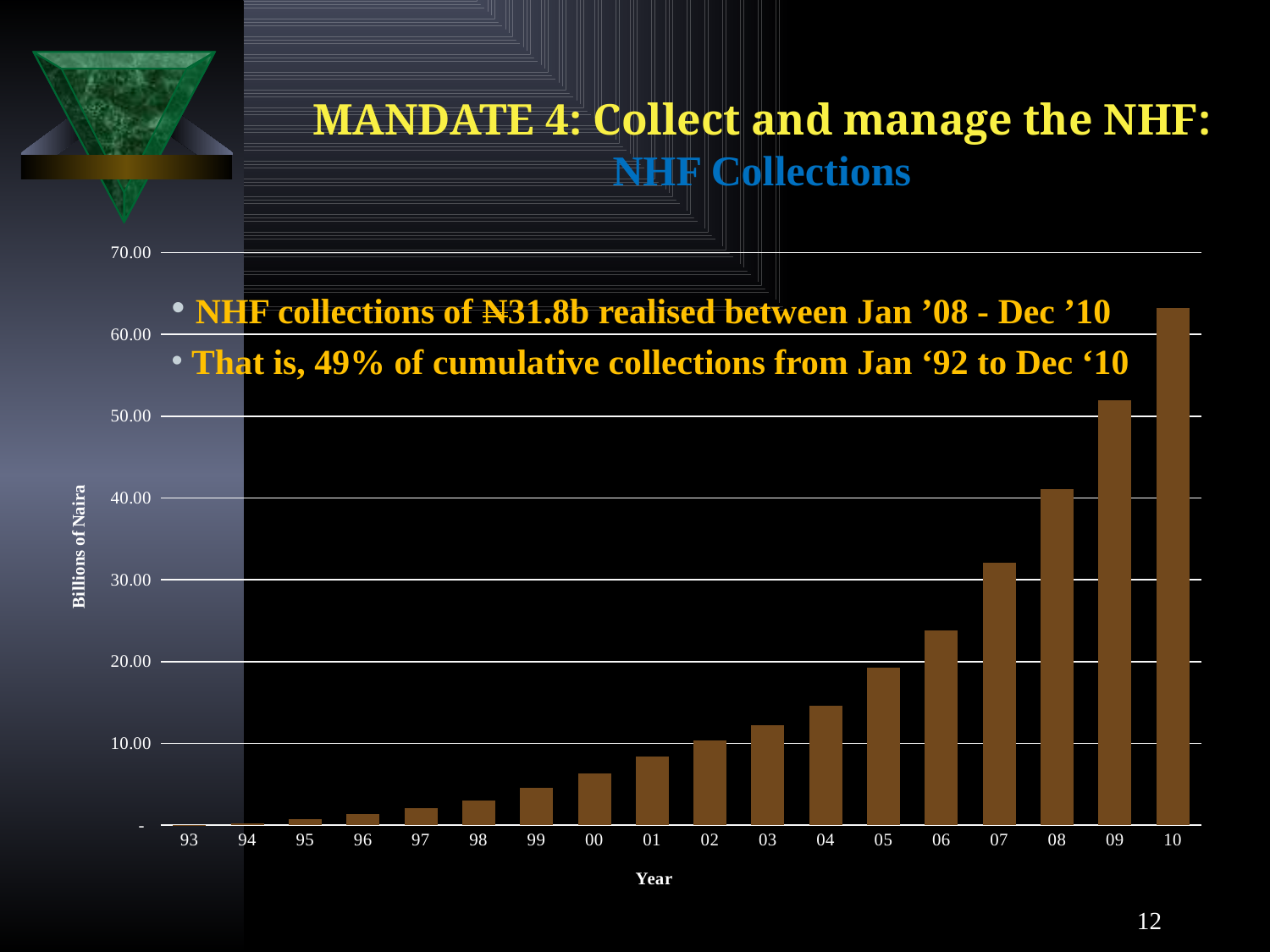
Which year has the larger NHF collections, 08 or 06? 08 Which year has the highest NHF collections? 10 How many years are shown along the x axis of the NHF Collections chart? 18 Do NHF collections generally rise or fall from 93 to 10? rise Is the value for 07 greater or less than 40.00? less Is the value for 10 greater or less than 60.00? greater What kind of chart is shown on the slide? bar chart What is the label of the y axis? Billions of Naira Is the value for 09 greater or less than 50.00? greater What is the label of the x axis? Year